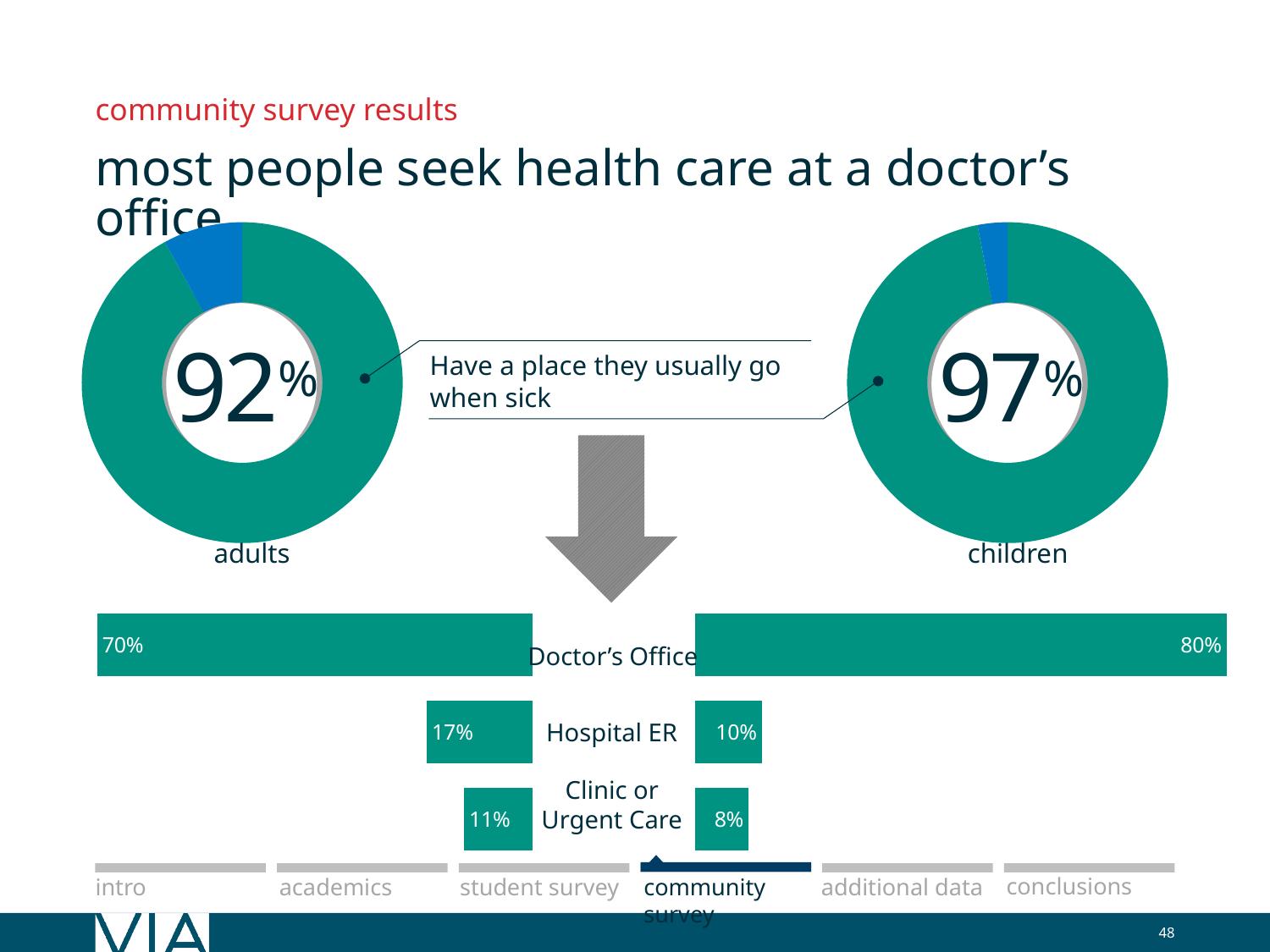
In the bar chart at the bottom, what percentage of adults seek care at a Hospital ER? 17% In the bar chart at the bottom, what percentage of children seek care at a Doctor's Office? 80% How many places of care are listed in the bar chart at the bottom? 3 In the bar chart at the bottom, what percentage of children seek care at a Clinic or Urgent Care? 8% In the adults donut chart, what percentage of adults have a place they usually go when sick? 92% What is the difference between the children's and adults' percentages shown in the two donut charts? 5% Comparing the two donut charts, which group has the higher share with a place they usually go when sick, adults or children? children In the children donut chart, what percentage of children have a place they usually go when sick? 97% What type of chart is used to show the 92% and 97% figures at the top of the slide? Donut chart In the bar chart at the bottom, what percentage of adults seek care at a Doctor's Office? 70% In the bar chart at the bottom, what is the difference between the adults' and children's Hospital ER percentages? 7% In the bar chart at the bottom, which place of care has the lowest percentage for adults? Clinic or Urgent Care